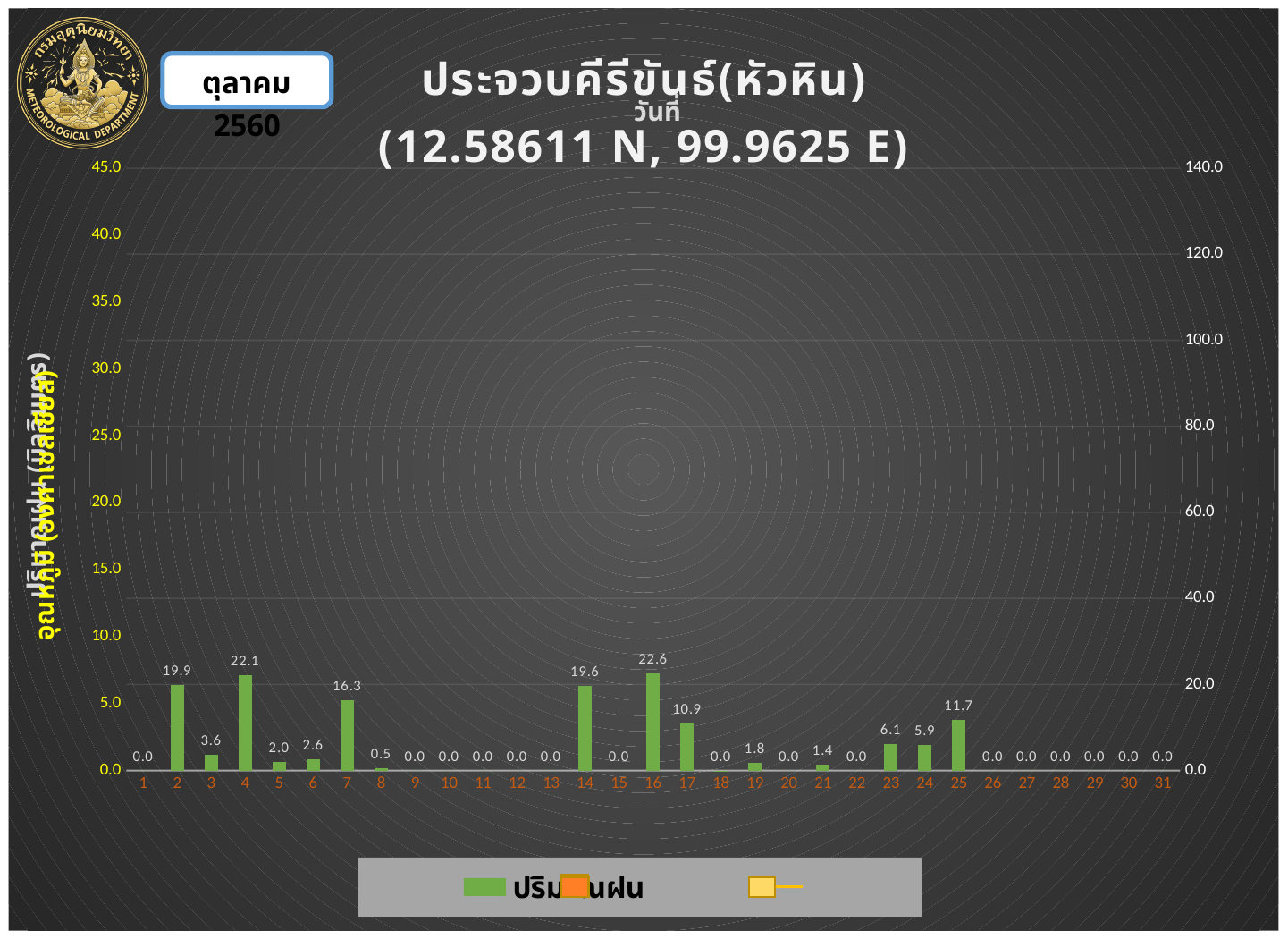
What is the highest value shown on the left y axis? 45.0 What kind of chart is shown on the slide? bar chart Which has the larger rainfall value, day 14 or day 7? day 14 What is the difference between the rainfall values for day 16 and day 17? 11.7 What is the rainfall value shown for day 25? 11.7 What is the rainfall value shown for day 16? 22.6 Which day has the highest rainfall value? 16 What is the rainfall value shown for day 2? 19.9 What is the difference between the rainfall values for day 4 and day 3? 18.5 Which has the larger rainfall value, day 23 or day 24? day 23 How many days are shown on the x axis? 31 What is the rainfall value shown for day 7? 16.3